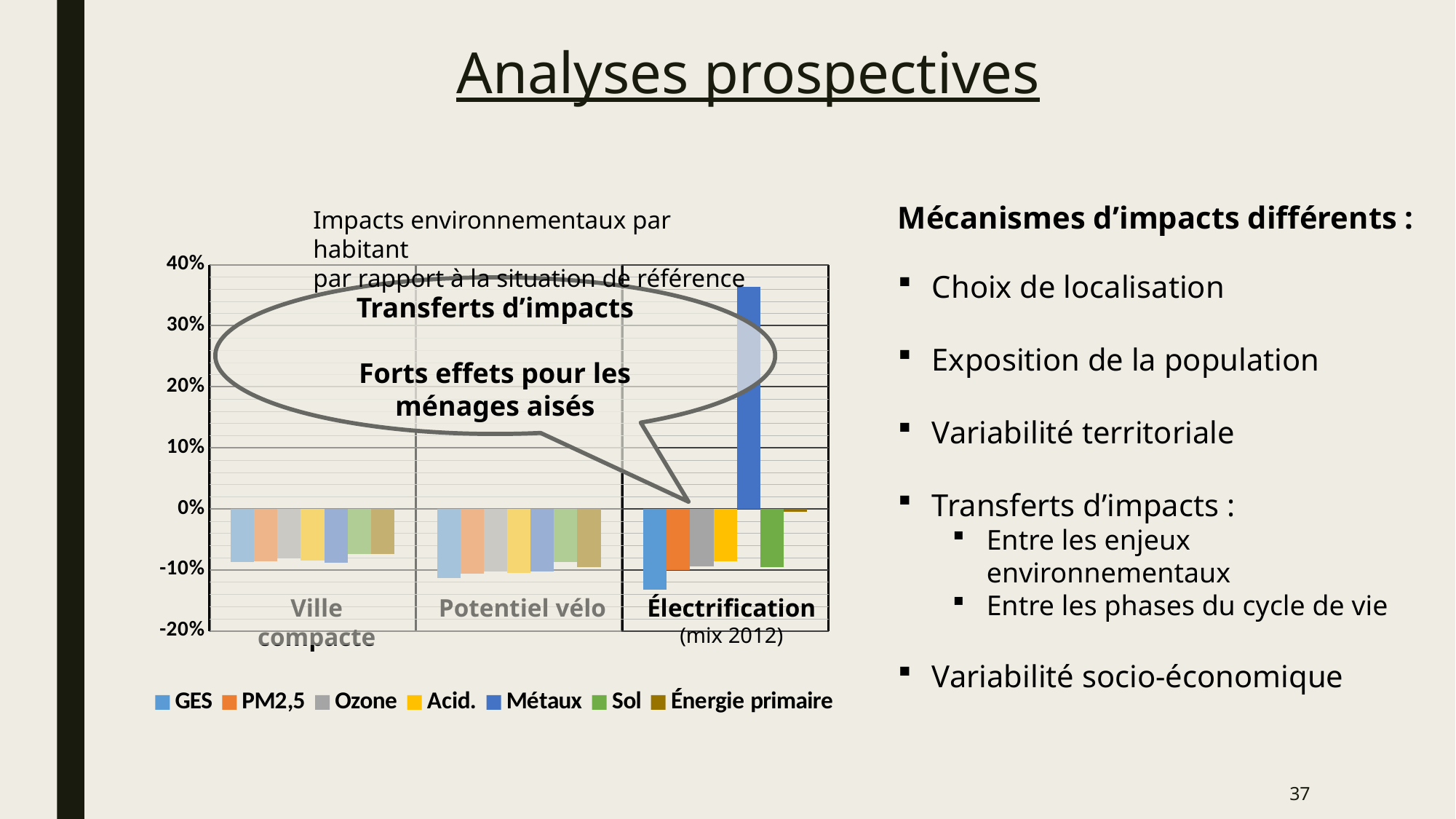
How many series does the chart legend list? 7 Which category has the highest GES value? Ville compacte Is the value for Métaux in the Électrification (mix 2012) category greater or less than 0%? greater Is the value for GES in the Ville compacte category greater or less than -10%? greater Is the value for GES in the Électrification (mix 2012) category greater or less than -10%? less Which series is shown in dark blue in the chart legend? Métaux How many categories are shown on the x axis of the chart? 3 What kind of chart is shown on the slide? bar chart What is the highest tick value shown on the y axis of the chart? 40% In the Électrification (mix 2012) category, which series has the highest value? Métaux Which is larger: the Métaux value for Électrification (mix 2012) or the Métaux value for Ville compacte? Électrification (mix 2012)